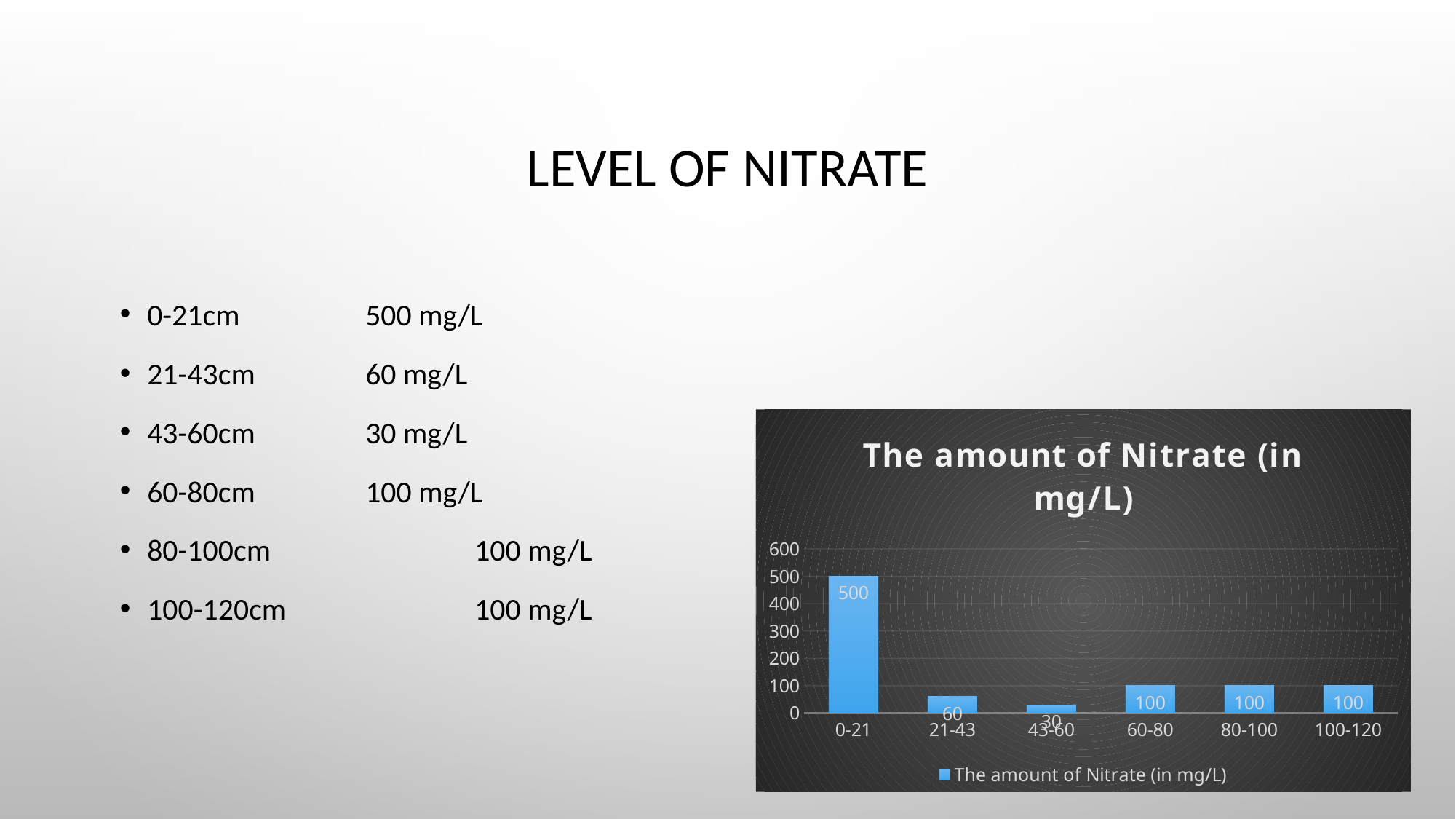
Which category has the lowest amount of nitrate? 43-60 What is the amount of nitrate for the 80-100 category? 100 What is the title of the chart? The amount of Nitrate (in mg/L) What is the difference between the nitrate amounts for 21-43 and 43-60? 30 How many categories are shown on the x axis of the chart? 6 Which category has the highest amount of nitrate? 0-21 What is the difference between the nitrate amounts for 0-21 and 60-80? 400 What is the amount of nitrate for the 21-43 category? 60 What is the amount of nitrate for the 0-21 category? 500 What is the amount of nitrate for the 43-60 category? 30 Which has a larger nitrate amount, 21-43 or 100-120? 100-120 What kind of chart is shown on the slide? bar chart